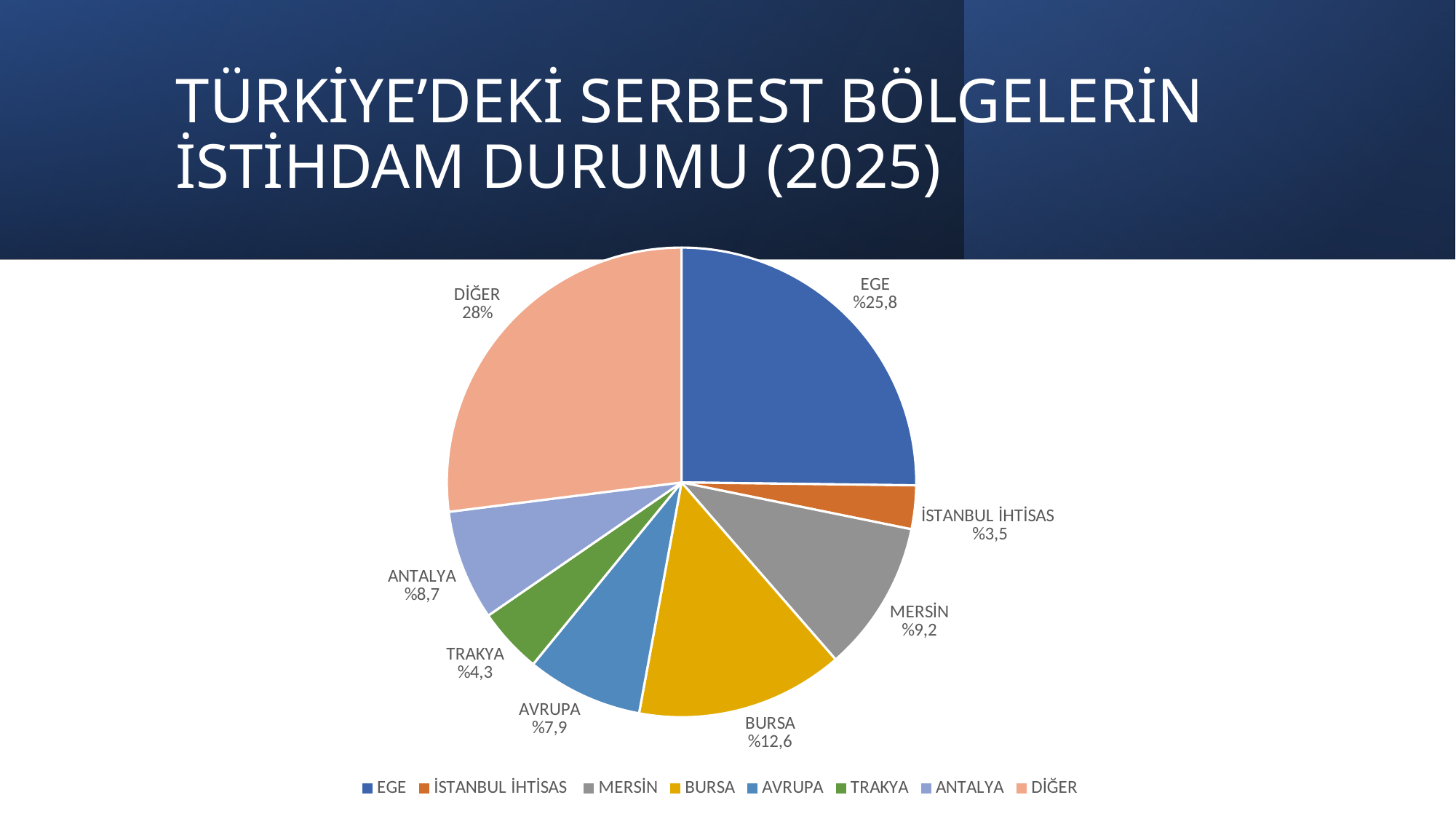
What is the share shown for İSTANBUL İHTİSAS? %3,5 What is the share shown for DİĞER? 28% Which slice has the smallest share? İSTANBUL İHTİSAS What kind of chart is shown on the slide? Pie chart What is the share shown for BURSA? %12,6 What is the share shown for EGE? %25,8 What is the difference in percentage points between the shares of BURSA and AVRUPA? 4,7 What is the title of the slide? TÜRKİYE'DEKİ SERBEST BÖLGELERİN İSTİHDAM DURUMU (2025) Which slice has the largest share? DİĞER Which has the larger share, MERSİN or ANTALYA? MERSİN How many entries does the legend list? 8 How many slices does the pie chart have? 8